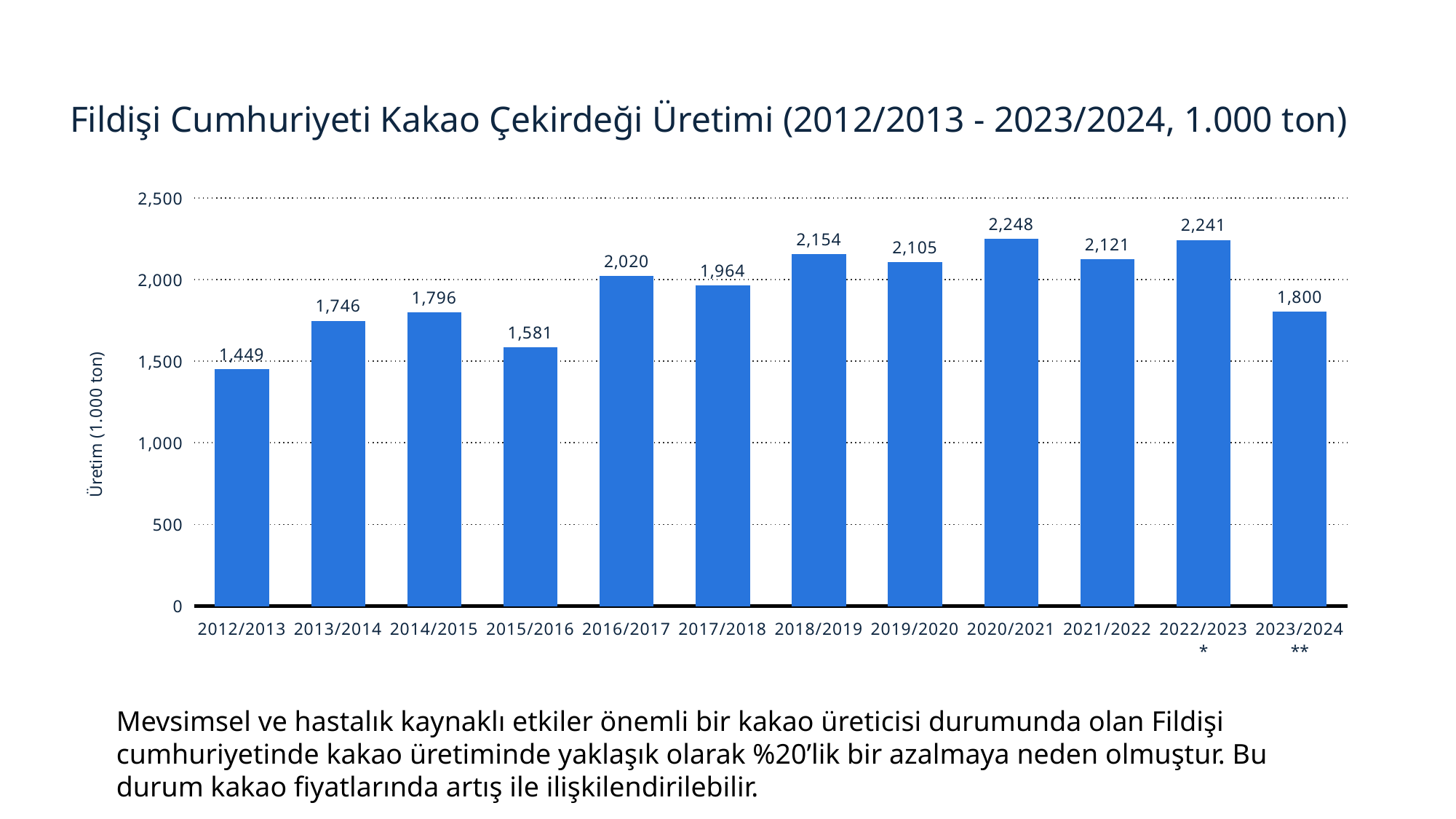
How many seasons are shown on the x axis? 12 What kind of chart is shown on the slide? bar chart Which season has the highest production? 2020/2021 What is the production value for 2018/2019? 2,154 What is the production value shown for 2023/2024? 1,800 What is the difference between the 2022/2023 and 2023/2024 production values? 441 What is the label of the y axis? Üretim (1.000 ton) What is the cocoa bean production value for 2012/2013? 1,449 Does production rise or fall from 2012/2013 to 2013/2014? rise Which is larger, the production in 2016/2017 or in 2017/2018? 2016/2017 Is the value for 2015/2016 greater or less than 2,000? less Which season has the lowest production? 2012/2013